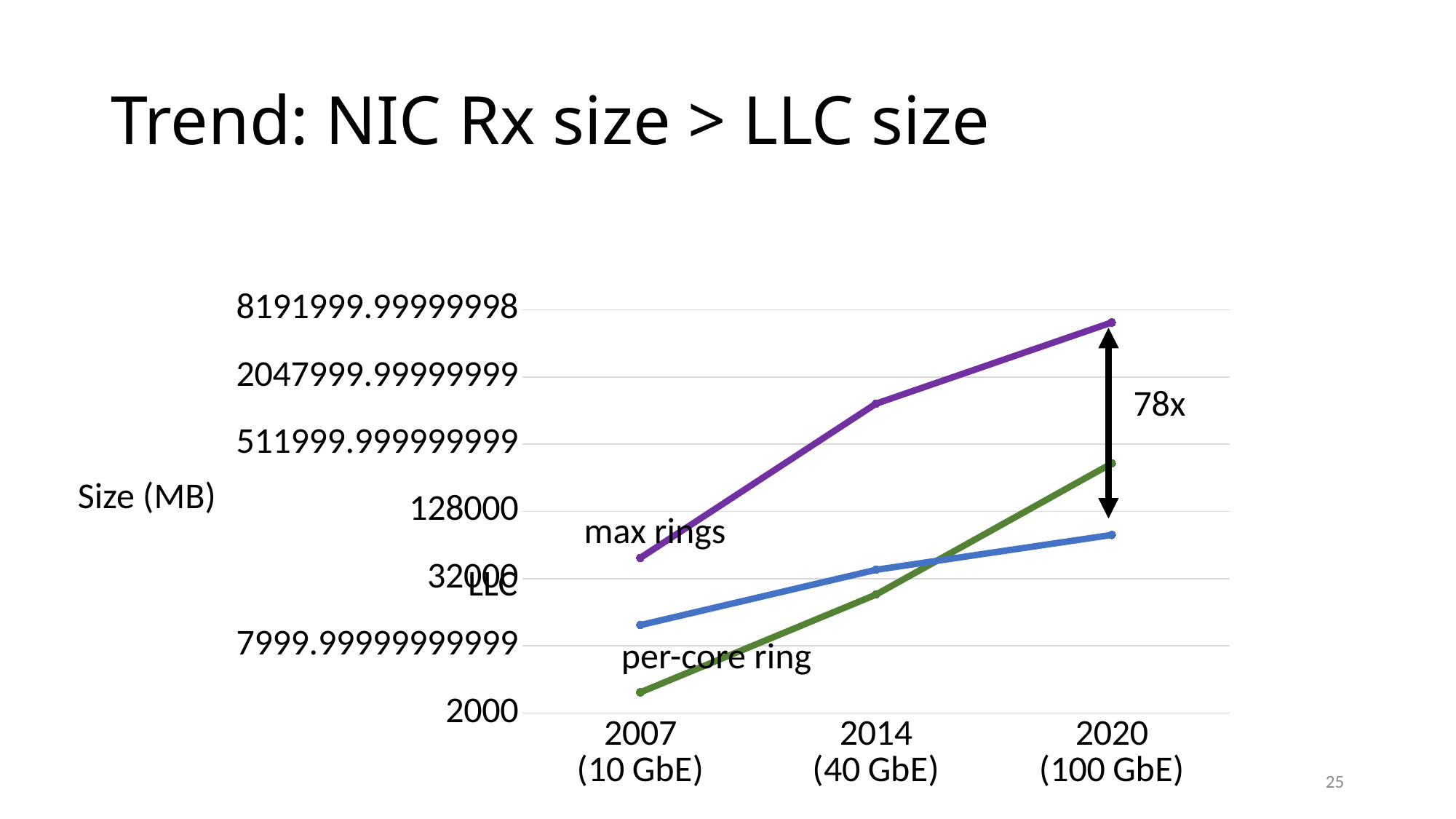
Which series has the highest value in 2020 (100 GbE)? max rings Is the value for LLC in 2020 (100 GbE) greater or less than 128000? less What kind of chart is shown on the slide? line chart Is the value for per-core ring in 2007 (10 GbE) greater or less than 7999.9999999999? less How many series are plotted on the chart? 3 Which series has the lowest value in 2007 (10 GbE)? per-core ring Is the value for max rings in 2020 (100 GbE) greater or less than 2047999.99999999? greater In 2007 (10 GbE), which is larger: LLC or per-core ring? LLC How many points are plotted along the x axis for each series? 3 Does the max rings series rise or fall from 2007 to 2020? rises What is the label on the y axis of the chart? Size (MB) In 2020 (100 GbE), which is larger: per-core ring or LLC? per-core ring